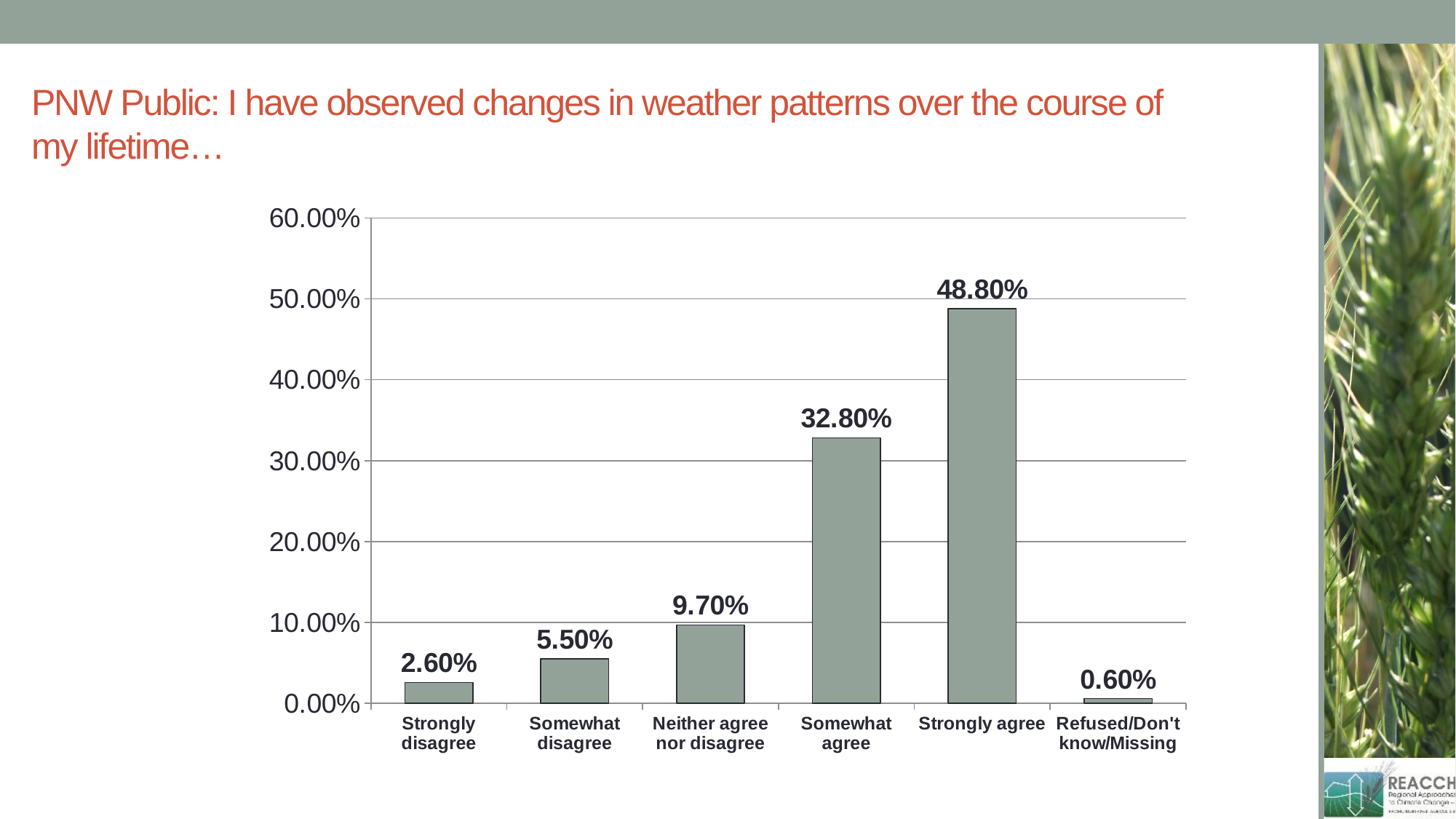
What is the combined value of "Strongly disagree" and "Somewhat disagree"? 8.10% What is the value for "Neither agree nor disagree"? 9.70% How many response categories are shown on the x axis? 6 What is the difference between the "Strongly agree" and "Somewhat agree" values? 16.00% What percentage of respondents answered "Strongly agree"? 48.80% What is the difference between the "Somewhat disagree" and "Strongly disagree" values? 2.90% What is the value for "Refused/Don't know/Missing"? 0.60% Which response category has the highest value? Strongly agree What kind of chart is shown on the slide? Bar chart Which is larger, the value for "Somewhat disagree" or the value for "Neither agree nor disagree"? Neither agree nor disagree Which response category has the lowest value? Refused/Don't know/Missing What is the value for "Somewhat agree"? 32.80%